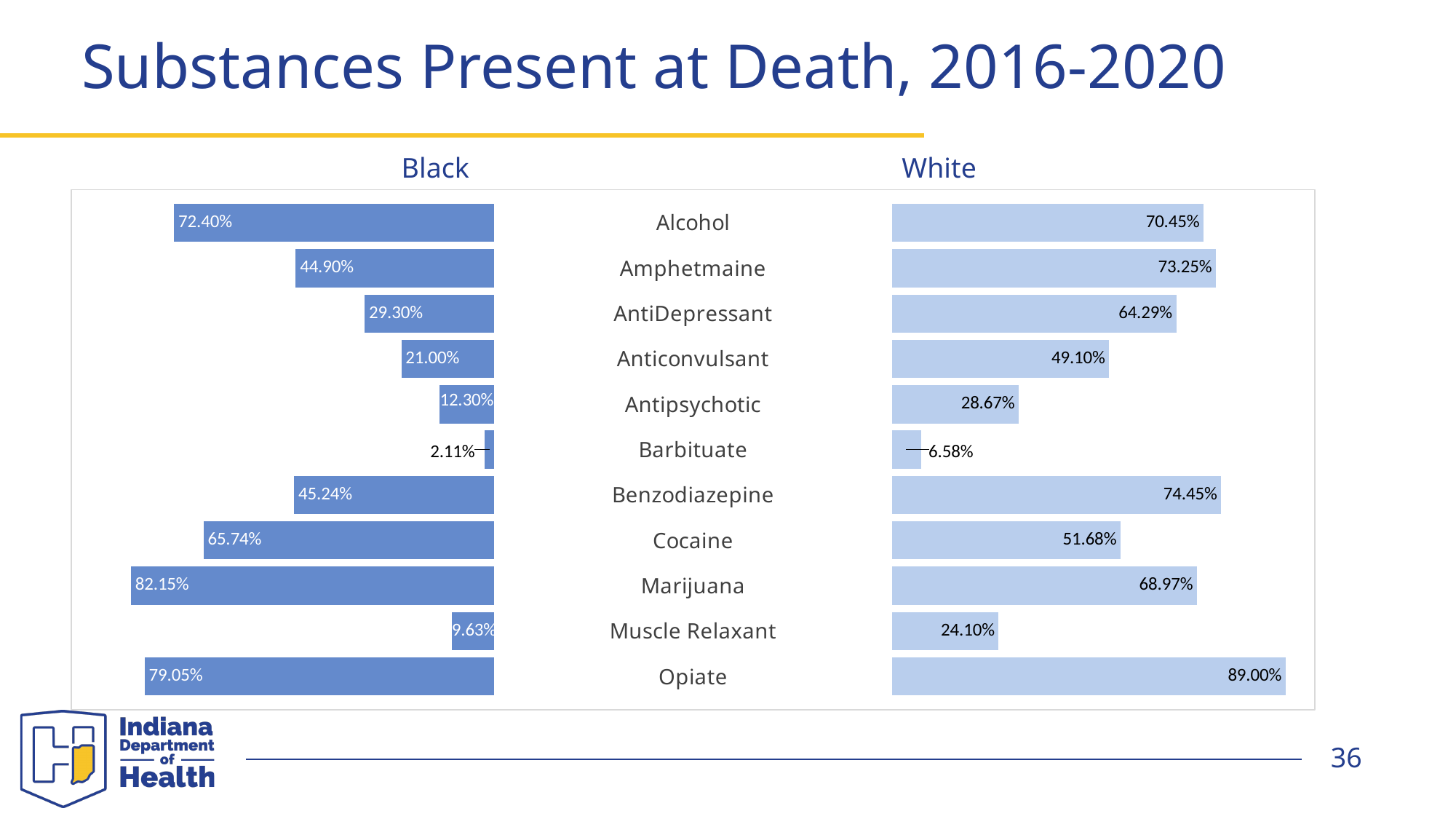
How many series does the chart show? 2 What is the Black value for Benzodiazepine? 45.24% What is the White value for Anticonvulsant? 49.10% For Cocaine, which is larger, the Black value or the White value? Black Which substance has the lowest White value? Barbituate What is the Black value for Marijuana? 82.15% What is the difference between the White and Black values for Opiate? 9.95 percentage points Which substance has the highest Black value? Marijuana Which substance has the highest White value? Opiate What is the White value for Opiate? 89.00% What kind of chart is shown on the slide? Bar chart How many substances are shown in the chart? 11